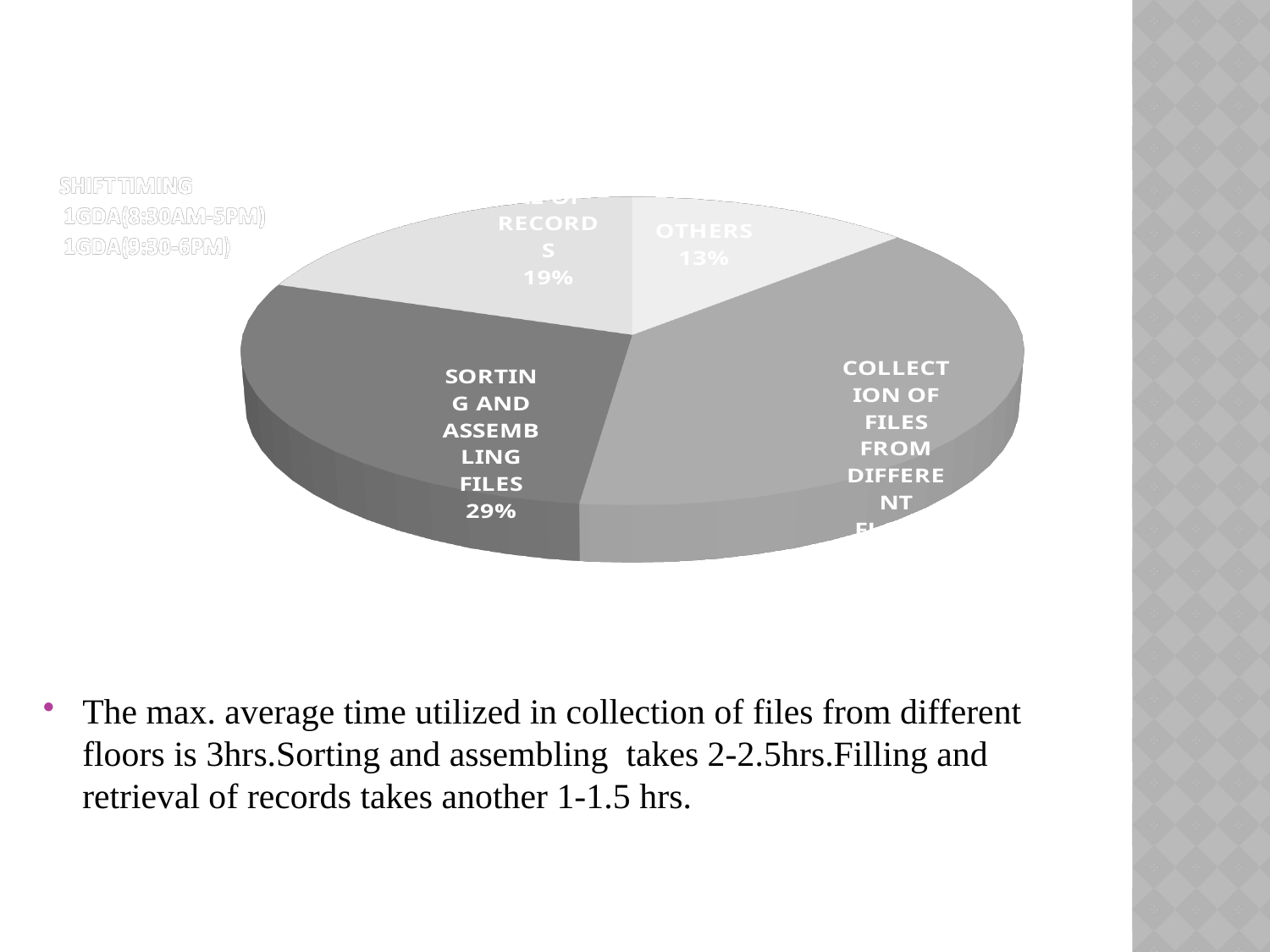
What kind of chart is shown on the slide? pie chart What percentage of the pie does the OTHERS slice represent? 13% What percentage of the pie does the SORTING AND ASSEMBLING FILES slice represent? 29% How many slices does the pie chart have? 4 Which slice is larger, SORTING AND ASSEMBLING FILES or OTHERS? SORTING AND ASSEMBLING FILES Which slice of the pie chart is the largest? COLLECTION OF FILES FROM DIFFERENT FLOORS Which slice of the pie chart is the smallest? OTHERS By how many percentage points does the SORTING AND ASSEMBLING FILES slice exceed the OTHERS slice? 16 Which slice is larger, COLLECTION OF FILES FROM DIFFERENT FLOORS or SORTING AND ASSEMBLING FILES? COLLECTION OF FILES FROM DIFFERENT FLOORS Is the pie chart drawn in 3D or flat 2D? 3D